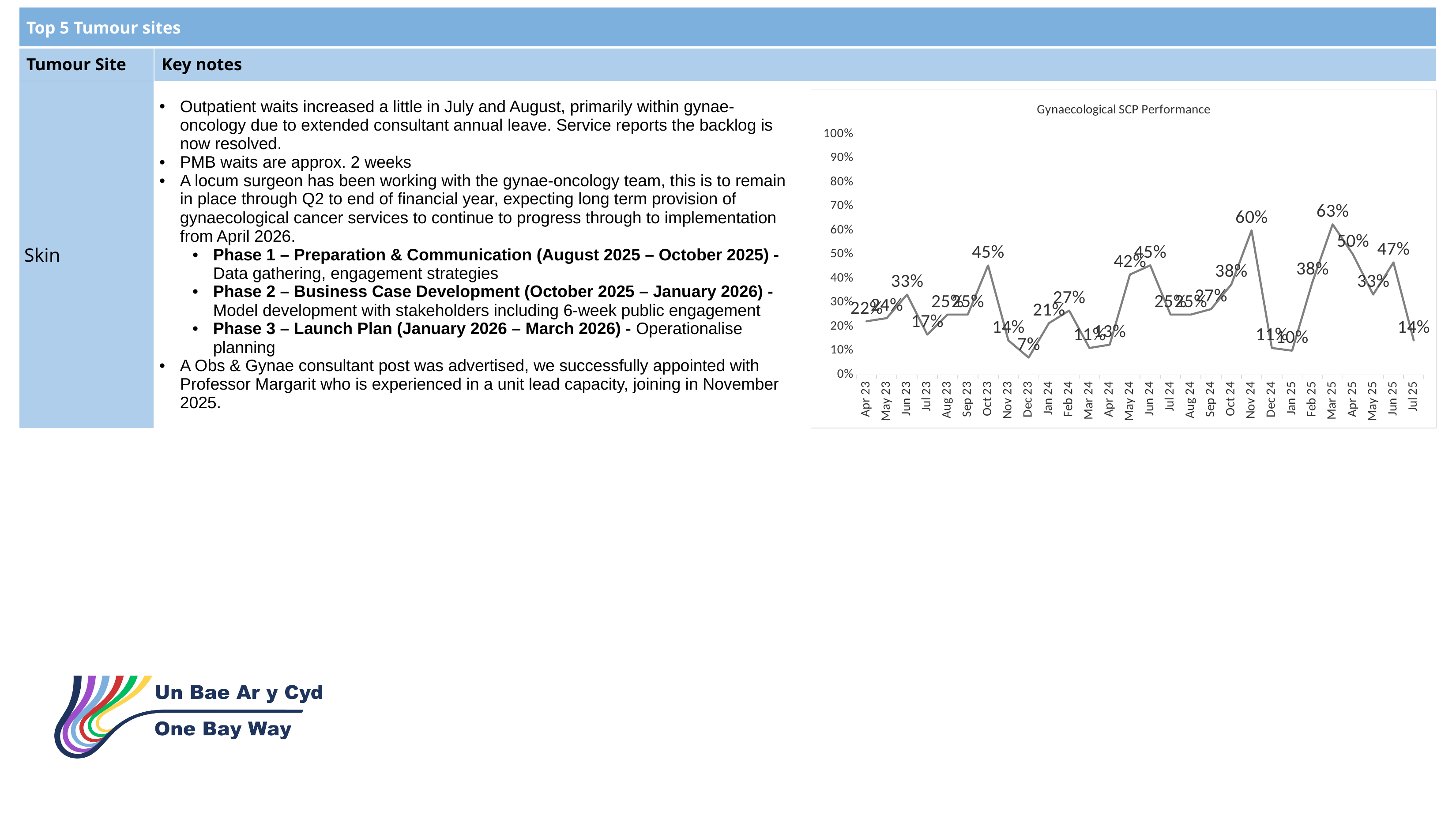
What is the title of the chart on the slide? Gynaecological SCP Performance What type of chart is the Gynaecological SCP Performance chart? line chart What is the difference between the Gynaecological SCP Performance values for Mar 25 and Apr 25? 13% What is the Gynaecological SCP Performance value for Dec 23? 7% What is the Gynaecological SCP Performance value for Nov 24? 60% What is the Gynaecological SCP Performance value for Mar 25? 63% Which is larger, the Gynaecological SCP Performance value for Oct 23 or for Jun 25? Jun 25 Is the Gynaecological SCP Performance value for Nov 24 greater or less than 50%? greater Which month has the highest Gynaecological SCP Performance value? Mar 25 How many months are plotted on the Gynaecological SCP Performance chart? 28 What is the Gynaecological SCP Performance value for Jul 25? 14% Which month has the lowest Gynaecological SCP Performance value? Dec 23